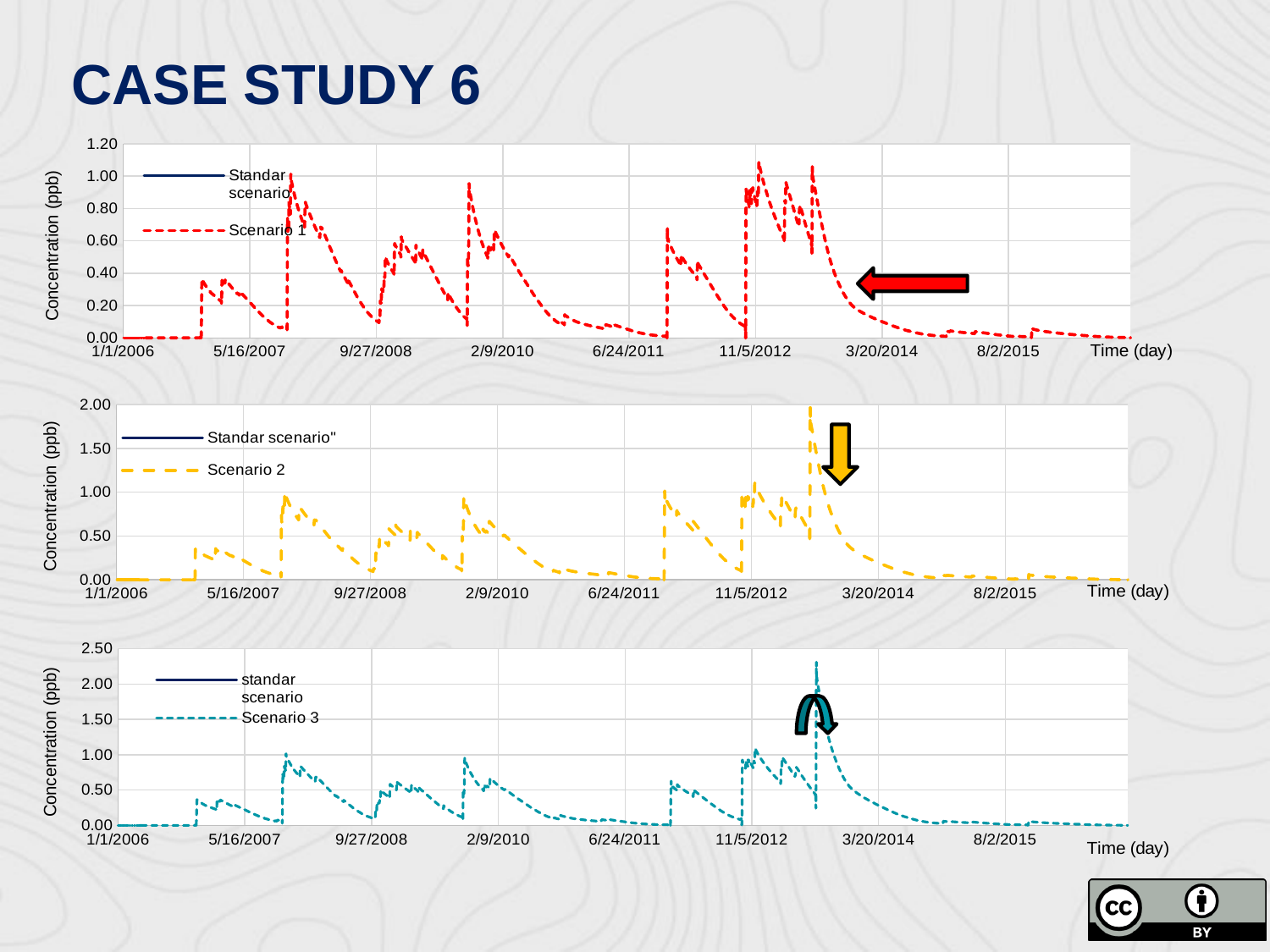
What are the two legend entries of the middle chart? Standar scenario" and Scenario 2 What is the label of the y axis on the bottom chart? Concentration (ppb) In the bottom chart, is the highest peak of Scenario 3 greater or less than 2.00? greater How many date labels are shown along the x axis of the middle chart? 8 In the middle chart, is the highest peak of Scenario 2 greater or less than 1.50? greater What is the maximum value shown on the y axis of the top chart? 1.20 How many series does the legend of the top chart list? 2 In the bottom chart, does the Scenario 3 line rise or fall between 3/20/2014 and 8/2/2015? fall In the top chart, is the value of Scenario 1 at 8/2/2015 greater or less than 0.20? less What kind of chart is the top chart on the slide? line chart What is the maximum value shown on the y axis of the bottom chart? 2.50